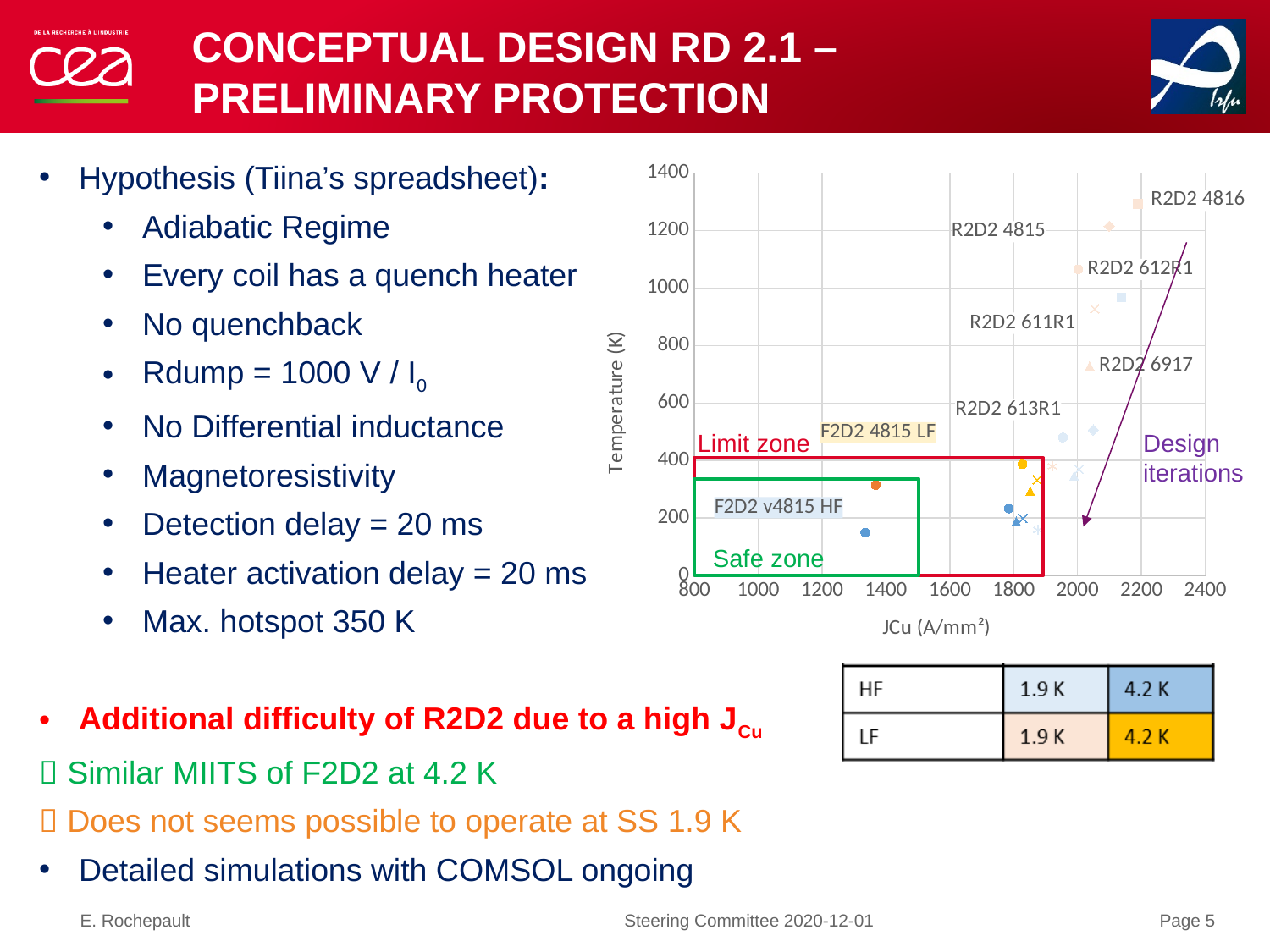
Is the temperature for F2D2 4815 LF greater or less than 400 K? less What is the title of the y axis of the chart? Temperature (K) Which has a higher temperature, R2D2 4816 or R2D2 6917? R2D2 4816 What kind of chart is shown on the slide? scatter chart Which labeled point has the highest temperature in the chart? R2D2 4816 Is the temperature for R2D2 612R1 greater or less than 1000 K? greater Is the temperature for R2D2 4816 greater or less than 1200 K? greater What is the title of the x axis of the chart? JCu (A/mm²) Which has a higher temperature, F2D2 4815 LF or F2D2 v4815 HF? F2D2 4815 LF